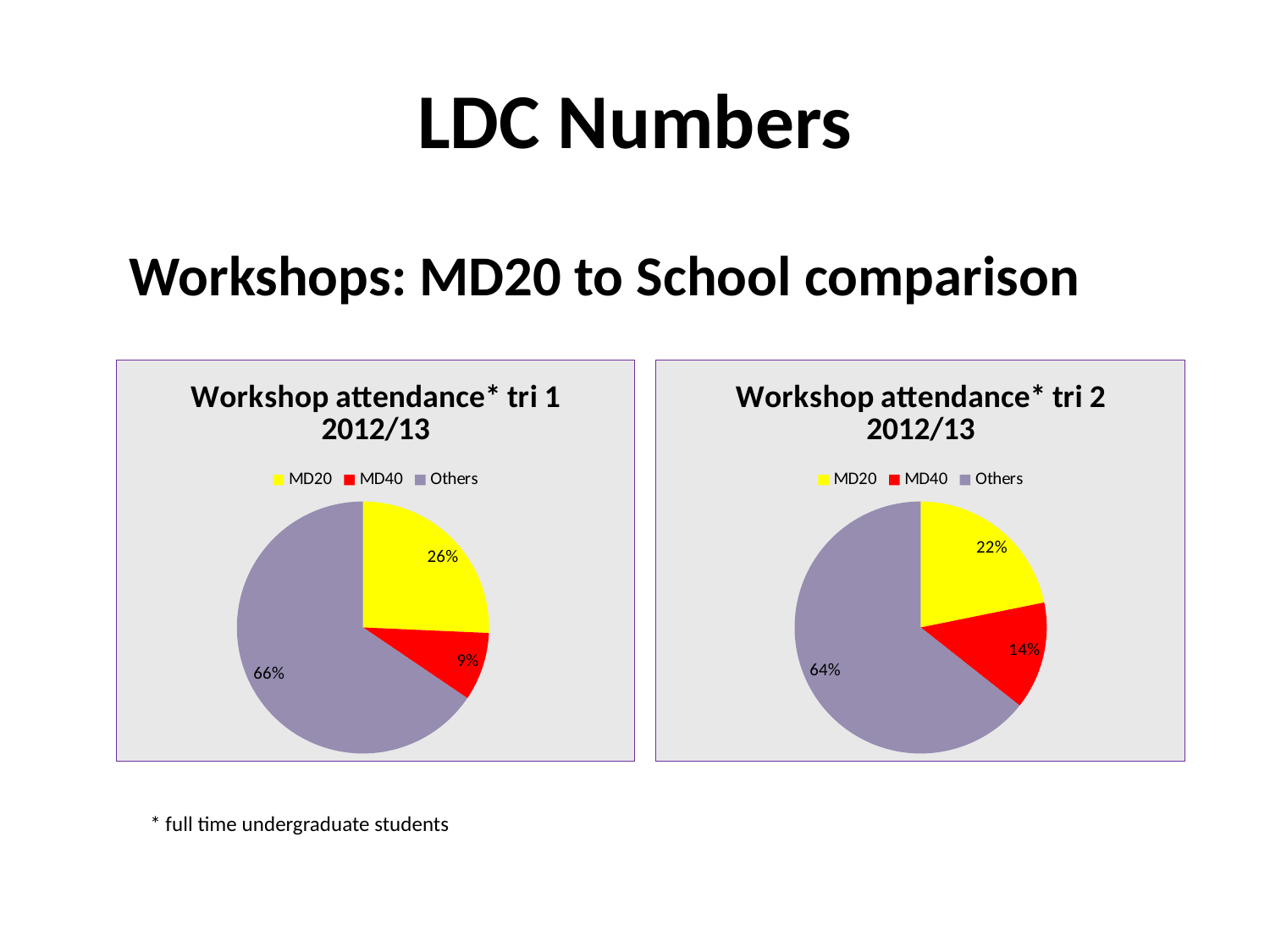
What type of chart is 'Workshop attendance* tri 2 2012/13'? Pie chart In the 'Workshop attendance* tri 2 2012/13' chart, what is the difference between the MD20 share and the MD40 share? 8% In the 'Workshop attendance* tri 1 2012/13' chart, what is the difference between the Others share and the MD20 share? 40% In the 'Workshop attendance* tri 2 2012/13' chart, what share does Others have? 64% In the 'Workshop attendance* tri 1 2012/13' chart, what share does MD40 have? 9% In the 'Workshop attendance* tri 1 2012/13' chart, what share does MD20 have? 26% In the 'Workshop attendance* tri 1 2012/13' chart, what colour is the MD40 slice? Red In the 'Workshop attendance* tri 1 2012/13' chart, which category has the largest slice? Others How many slices does the 'Workshop attendance* tri 1 2012/13' pie chart have? 3 In the 'Workshop attendance* tri 2 2012/13' chart, which category has the smallest slice? MD40 In the 'Workshop attendance* tri 2 2012/13' chart, which is larger, the MD20 slice or the MD40 slice? MD20 In the 'Workshop attendance* tri 2 2012/13' chart, what share does MD40 have? 14%